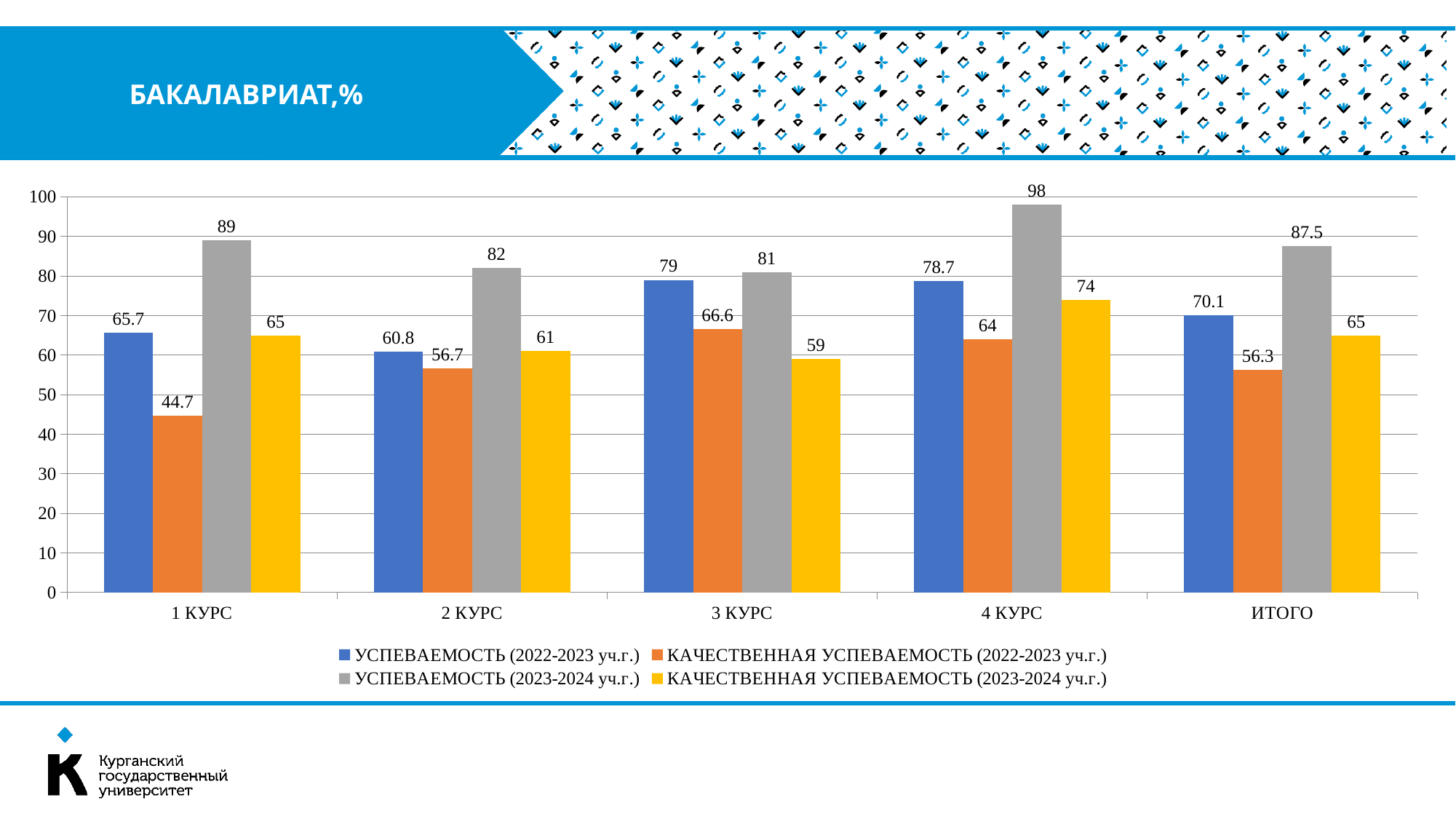
Is the value of УСПЕВАЕМОСТЬ (2023-2024 уч.г.) for ИТОГО greater or less than 80? greater What is the value of УСПЕВАЕМОСТЬ (2022-2023 уч.г.) for ИТОГО? 70.1 How many series does the legend list? 4 How many categories are shown on the x axis? 5 Which category has the highest value for УСПЕВАЕМОСТЬ (2023-2024 уч.г.)? 4 КУРС What is the value of УСПЕВАЕМОСТЬ (2023-2024 уч.г.) for 4 КУРС? 98 Which category has the lowest value for КАЧЕСТВЕННАЯ УСПЕВАЕМОСТЬ (2023-2024 уч.г.)? 3 КУРС What is the value of КАЧЕСТВЕННАЯ УСПЕВАЕМОСТЬ (2022-2023 уч.г.) for 1 КУРС? 44.7 For 3 КУРС, which is larger: КАЧЕСТВЕННАЯ УСПЕВАЕМОСТЬ (2022-2023 уч.г.) or КАЧЕСТВЕННАЯ УСПЕВАЕМОСТЬ (2023-2024 уч.г.)? КАЧЕСТВЕННАЯ УСПЕВАЕМОСТЬ (2022-2023 уч.г.) What kind of chart is shown on the slide? bar chart What is the title of the slide? БАКАЛАВРИАТ,% What is the difference between УСПЕВАЕМОСТЬ (2023-2024 уч.г.) and УСПЕВАЕМОСТЬ (2022-2023 уч.г.) for 1 КУРС? 23.3